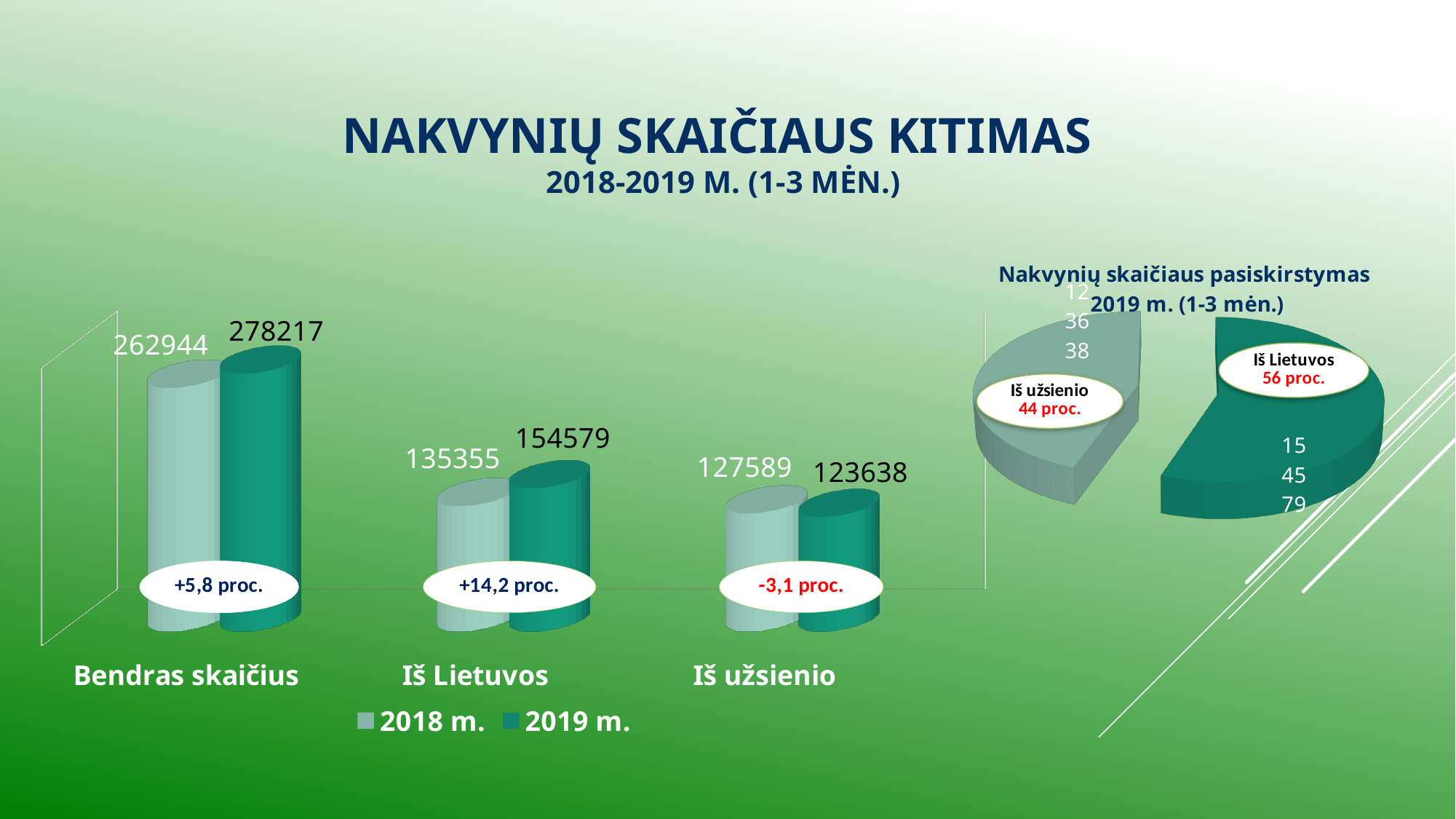
In the bar chart, which category has the highest value in 2019 m.? Bendras skaičius In the bar chart, what is the value for Bendras skaičius in 2019 m.? 278217 In the pie chart titled 'Nakvynių skaičiaus pasiskirstymas 2019 m. (1-3 mėn.)', what share does Iš Lietuvos have? 56 proc. In the bar chart, what is the value for Iš Lietuvos in 2018 m.? 135355 In the bar chart, which category has the lowest value in 2019 m.? Iš užsienio How many categories does the bar chart show? 3 What percentage change is shown for Iš užsienio in the bar chart? -3,1 proc. In the bar chart, what is the value for Bendras skaičius in 2018 m.? 262944 How many series does the bar chart legend list? 2 In the bar chart, what is the difference between the 2019 m. and 2018 m. values for Iš Lietuvos? 19224 In the bar chart, which is larger for Iš užsienio: the 2018 m. value or the 2019 m. value? 2018 m. In the bar chart, what is the value for Iš užsienio in 2019 m.? 123638